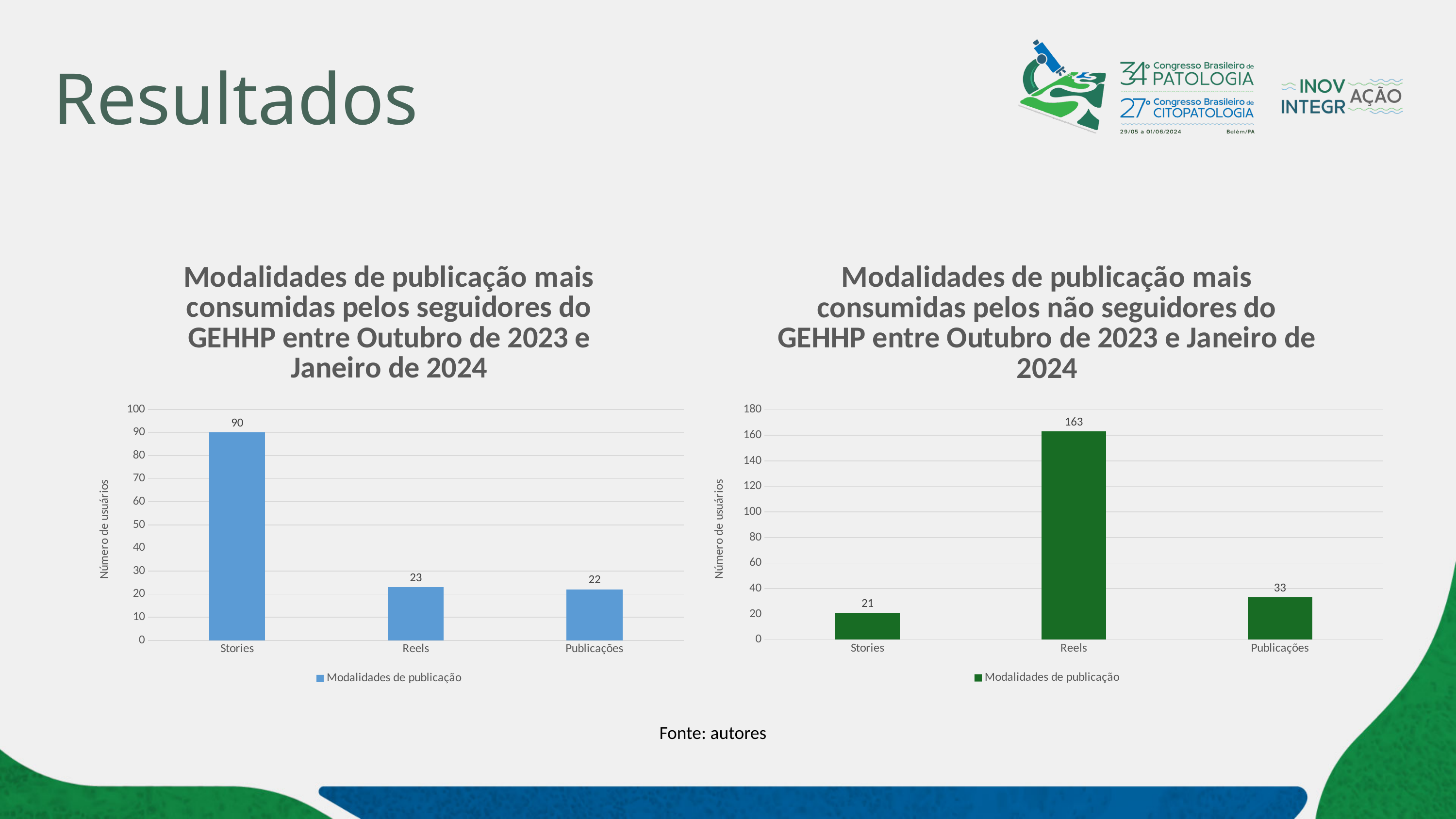
What is the legend entry shown below the left chart (seguidores)? Modalidades de publicação In the right chart (não seguidores), which category has the lowest value? Stories In the left chart (seguidores), what is the value for Stories? 90 How many categories are shown in the left chart (seguidores)? 3 In the left chart (seguidores), which category has the highest value? Stories In the right chart (não seguidores), what is the value for Reels? 163 In the right chart (não seguidores), what is the difference between Reels and Publicações? 130 In the left chart (seguidores), what is the value for Reels? 23 In the right chart (não seguidores), which is larger, Stories or Publicações? Publicações In the left chart (seguidores), what is the difference between Stories and Publicações? 68 In the right chart (não seguidores), what is the value for Publicações? 33 What kind of chart is the right chart (não seguidores)? Bar chart